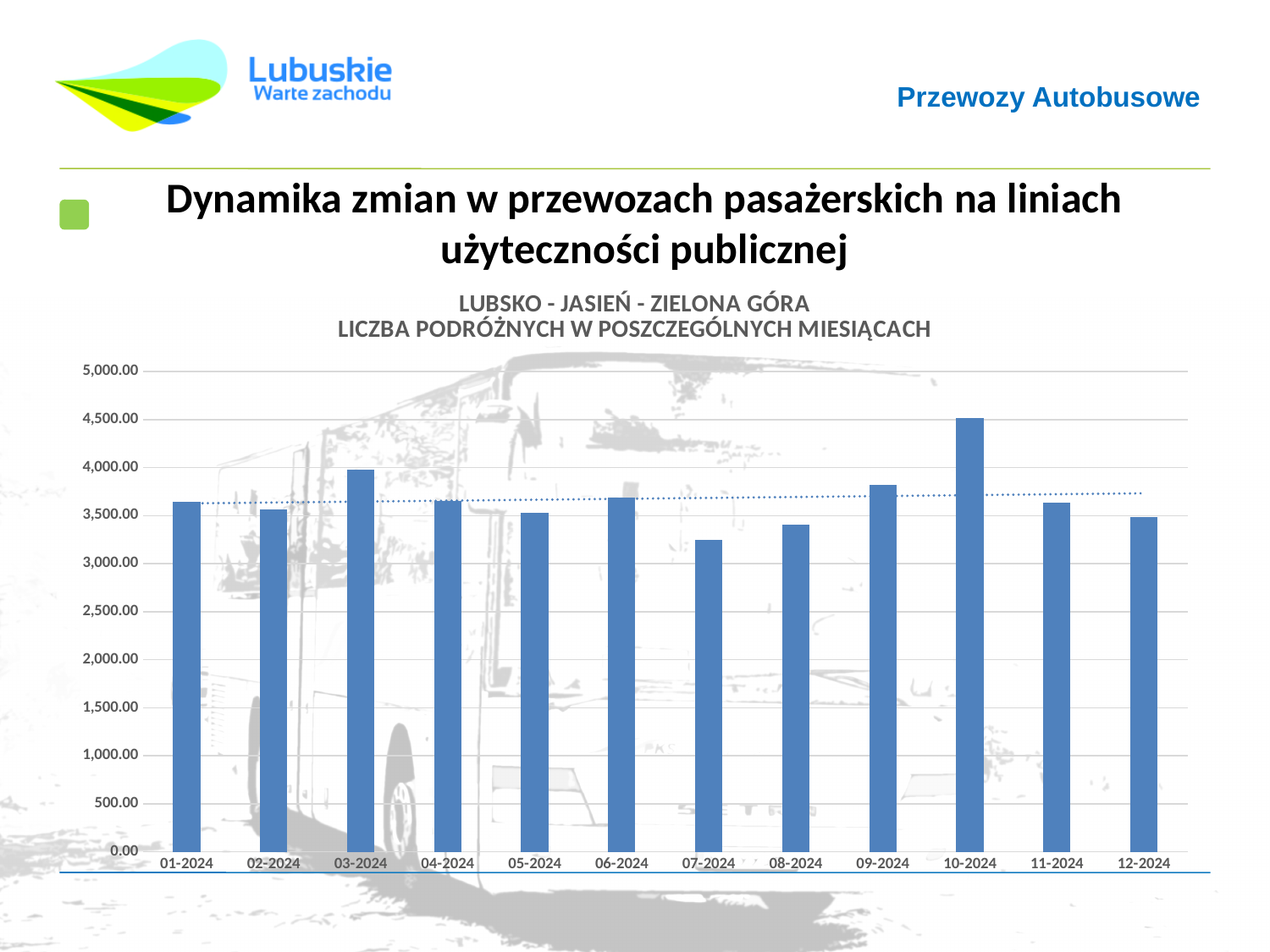
Is the value for 09-2024 greater or less than 3,500.00? greater Is the value for 03-2024 greater or less than 3,500.00? greater Which bus line does the chart title refer to? LUBSKO - JASIEŃ - ZIELONA GÓRA Is the value for 10-2024 greater or less than 4,000.00? greater Which is larger, the value for 10-2024 or the value for 03-2024? 10-2024 Which month has the highest number of passengers? 10-2024 Which month has the lowest number of passengers? 07-2024 How many months are plotted on the x axis of the chart? 12 What kind of chart is shown on the slide? bar chart Which is larger, the value for 07-2024 or the value for 08-2024? 08-2024